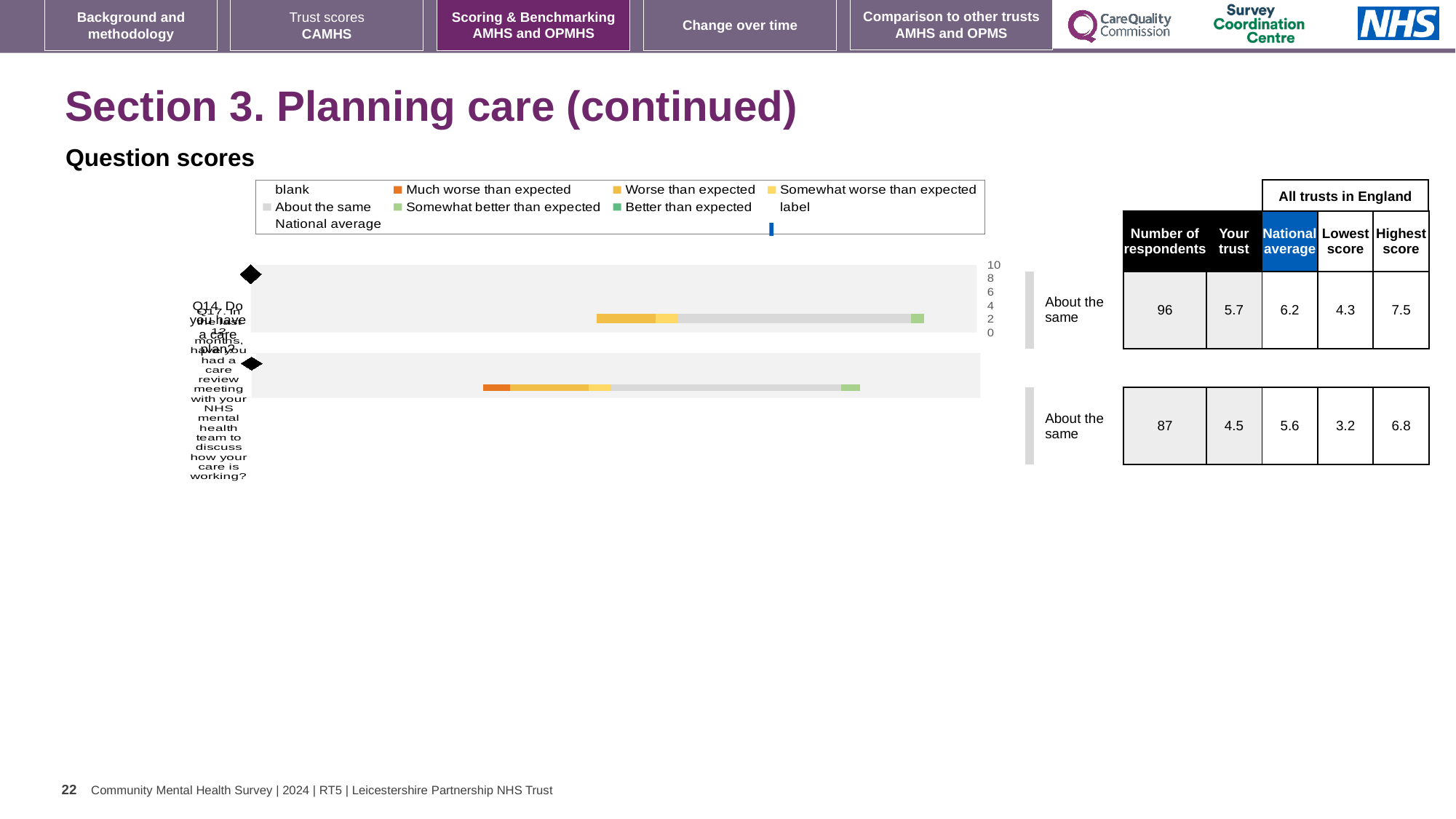
What benchmark category is shown for both Q14 and Q17? About the same What is the 'Your trust' score for Q14 (Do you have a care plan?)? 5.7 What is the national average score for Q14? 6.2 What is the lowest score among all trusts in England for Q14? 4.3 What is the difference between the national average and the 'Your trust' score for Q17? 1.1 What is the difference between the highest and lowest scores for Q14? 3.2 For Q14, which is larger: the 'Your trust' score or the national average? National average Which question has more respondents, Q14 or Q17? Q14 How many respondents answered Q17 (care review meeting in the last 12 months)? 87 What kind of chart is shown under 'Question scores'? Bar chart What is the highest score among all trusts in England for Q17? 6.8 How many questions (bars) are plotted in the chart? 2